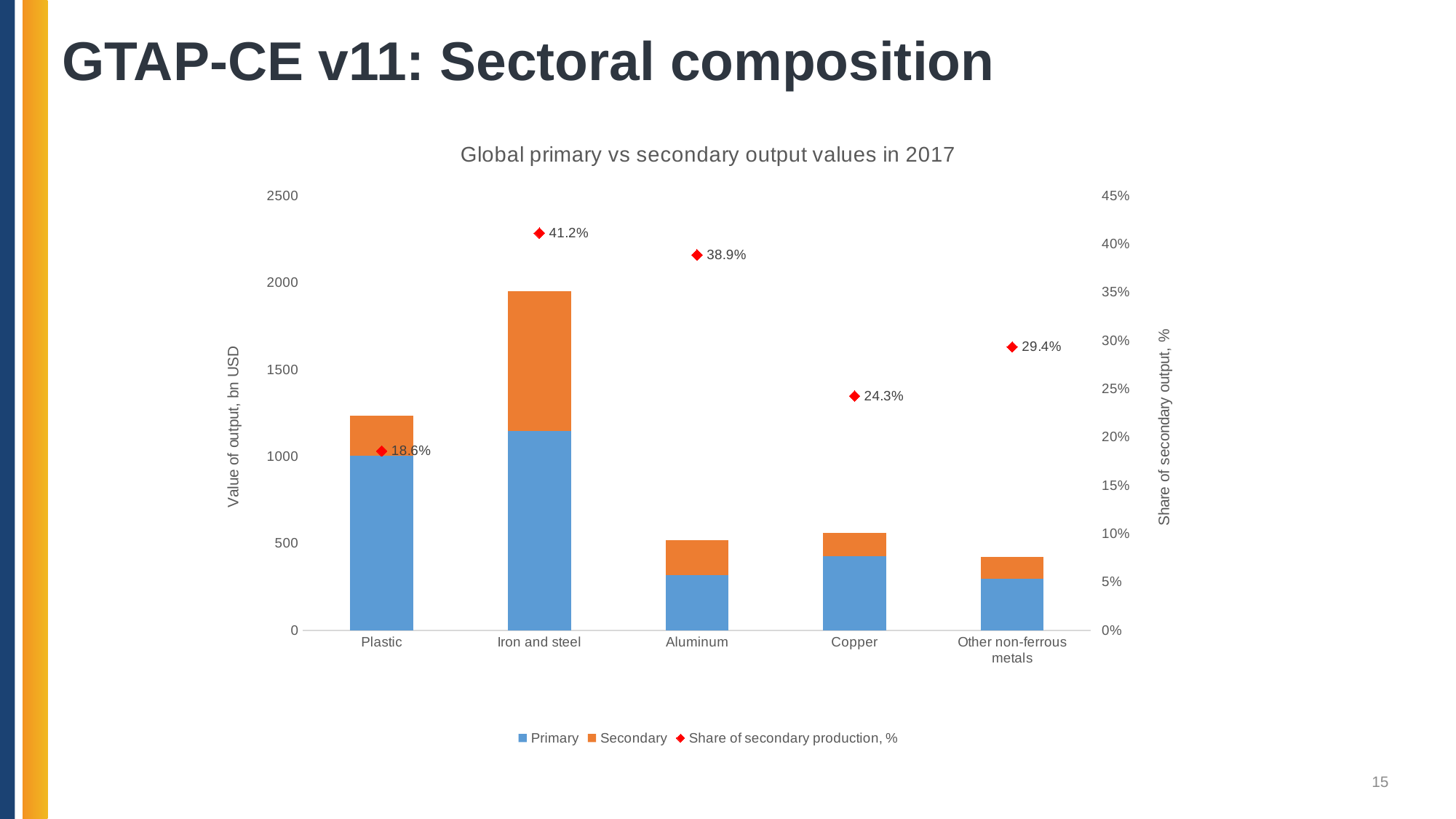
Is the total value of output for Iron and steel greater or less than 1500 bn USD? greater Which sector has the highest share of secondary production? Iron and steel Which has a larger share of secondary production, Aluminum or Copper? Aluminum Is the total value of output for Aluminum greater or less than 1000 bn USD? less How many series does the legend list? 3 Which sector has the lowest share of secondary production? Plastic What is the difference between the share of secondary production for Iron and steel and for Aluminum? 2.3 percentage points What is the share of secondary production for Plastic? 18.6% What is the share of secondary production for Iron and steel? 41.2% How many sectors are shown on the x axis? 5 What is the share of secondary production for Other non-ferrous metals? 29.4% Which sector has the tallest stacked bar for value of output? Iron and steel